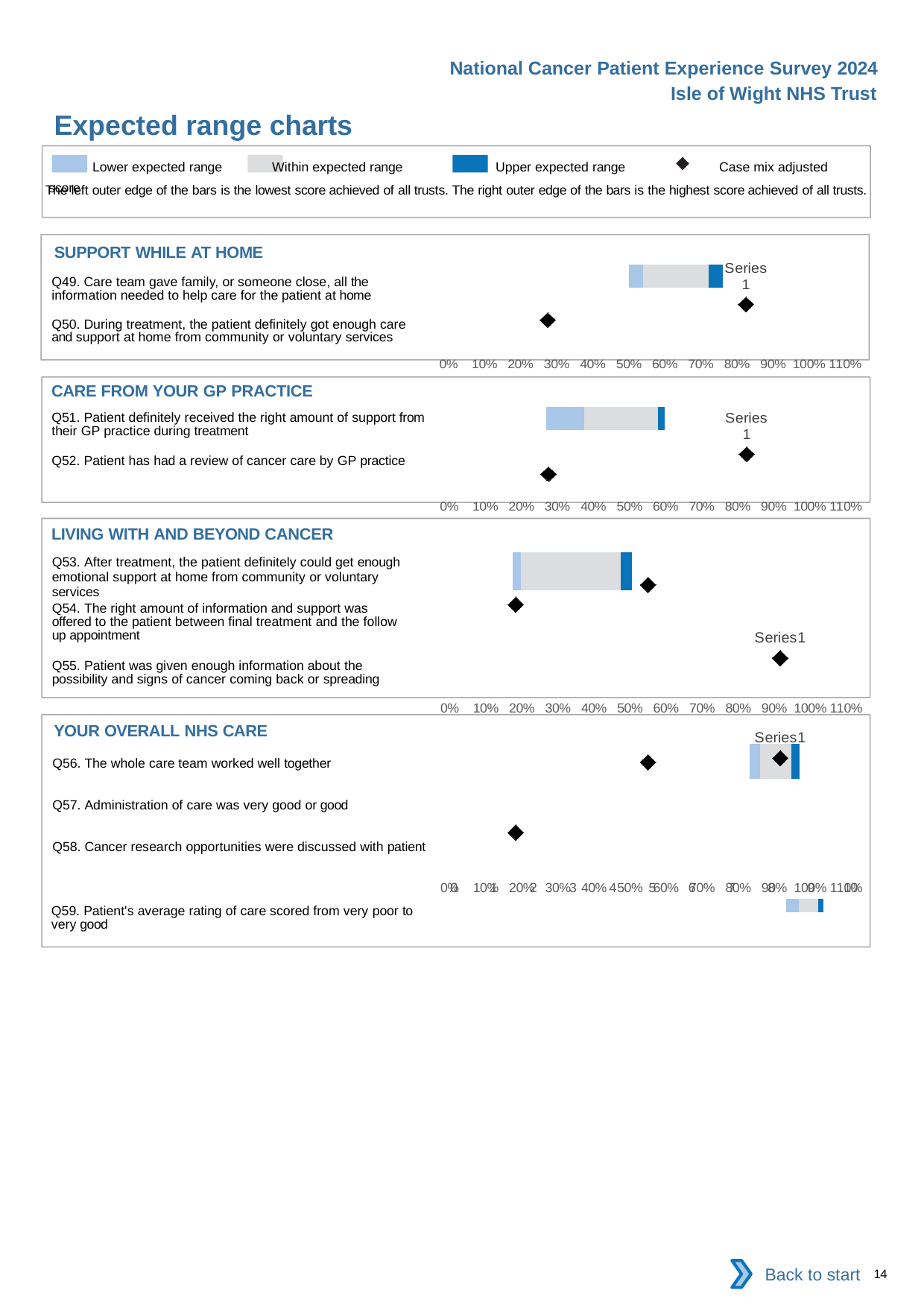
What kind of chart is used in the 'SUPPORT WHILE AT HOME' section? bar chart How many entries does the legend at the top of the slide list? 4 How many questions are listed in the 'LIVING WITH AND BEYOND CANCER' chart? 3 In the 'SUPPORT WHILE AT HOME' chart, is the case mix adjusted score for Q50 greater or less than 50%? less In the 'YOUR OVERALL NHS CARE' chart, is the case mix adjusted score for Q58 greater or less than 40%? less How many questions are listed in the 'YOUR OVERALL NHS CARE' chart? 4 In the 'LIVING WITH AND BEYOND CANCER' chart, is the case mix adjusted score for Q54 greater or less than 30%? less In the 'YOUR OVERALL NHS CARE' chart, which has the higher case mix adjusted score, Q56 or Q58? Q56 What is the highest tick label shown on the x axis of the 'CARE FROM YOUR GP PRACTICE' chart? 110% According to the legend, what symbol marks the case mix adjusted score? a black diamond